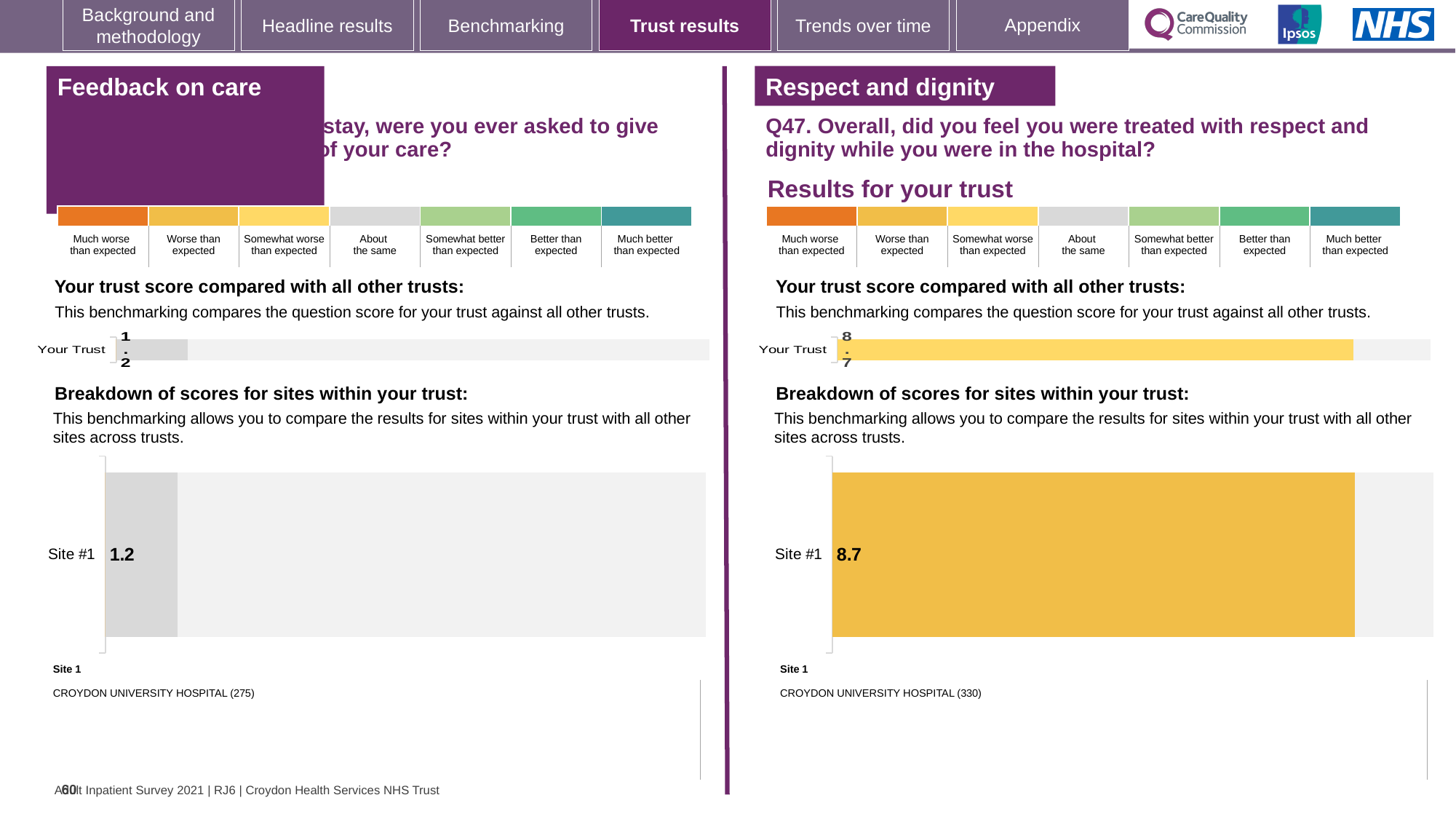
What type of chart is used to show the Site #1 score in the Respect and dignity section? Bar chart In the Feedback on care section, what is the score shown for Your Trust in the 'Your trust score compared with all other trusts' chart? 1.2 In the Respect and dignity section, what score is shown for Site #1 in the breakdown of scores for sites chart? 8.7 Which hospital is listed as Site 1 below the breakdown charts? Croydon University Hospital How many sites are shown in the breakdown of scores chart in the Respect and dignity section? 1 What is the difference between the Site #1 score in the Respect and dignity section and the Site #1 score in the Feedback on care section? 7.5 Which section shows the higher Site #1 score: Feedback on care or Respect and dignity? Respect and dignity In the Respect and dignity section, what is the score shown for Your Trust in the 'Your trust score compared with all other trusts' chart? 8.7 In the Respect and dignity section, what colour is the Site #1 bar in the breakdown of scores chart? Yellow Is the Your Trust score in the Respect and dignity section greater or less than the Your Trust score in the Feedback on care section? greater In the Feedback on care section, what score is shown for Site #1 in the breakdown of scores for sites chart? 1.2 How many sites are shown in the breakdown of scores chart in the Feedback on care section? 1